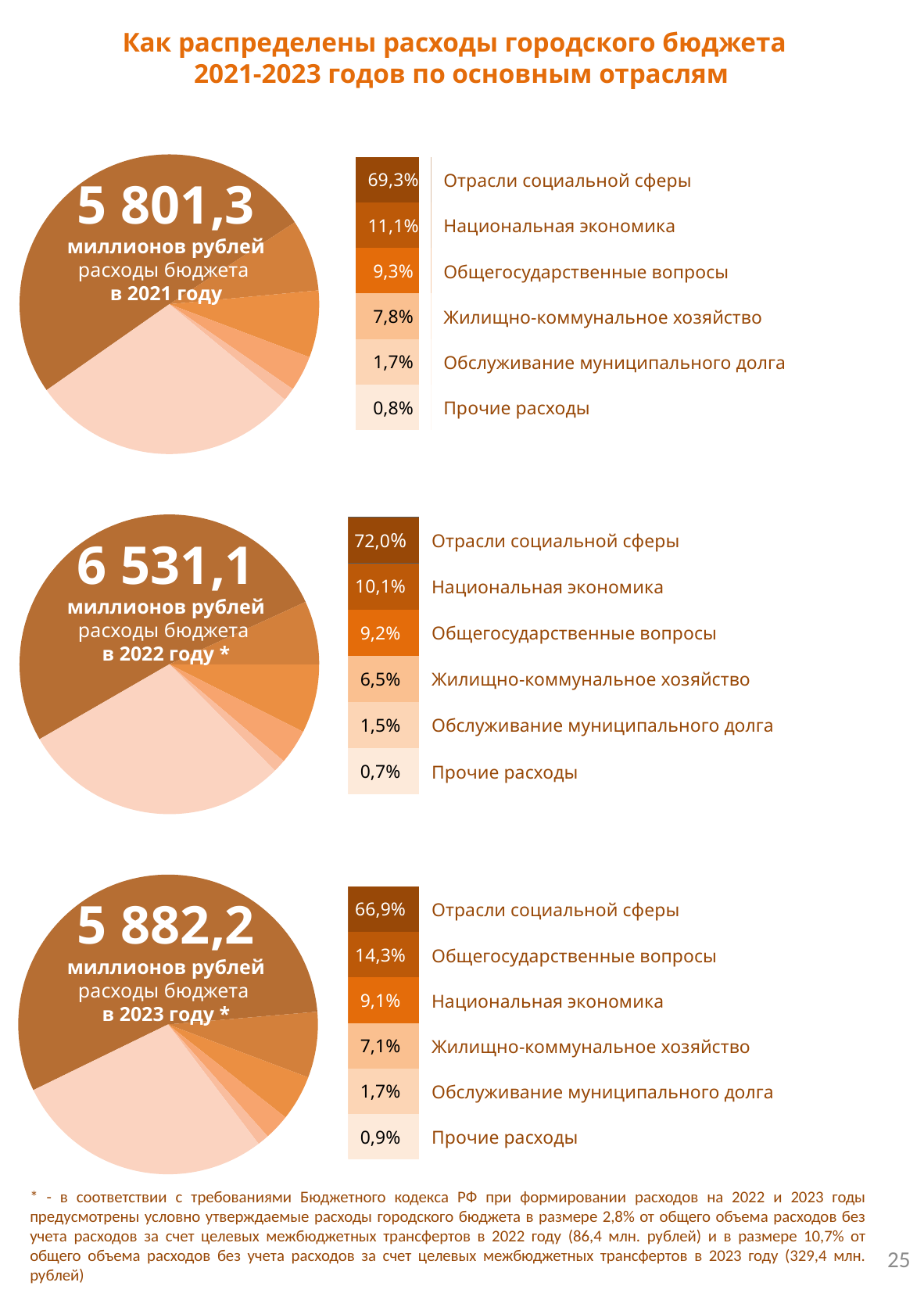
In the 2023 pie chart, which category has the smallest share? Прочие расходы In the 2022 pie chart, what share is shown for Жилищно-коммунальное хозяйство? 6,5% In the 2021 pie chart, what share of budget expenditures goes to Отрасли социальной сферы? 69,3% In the 2023 pie chart, what share is shown for Общегосударственные вопросы? 14,3% What total budget expenditure is shown in the centre of the 2022 pie chart? 6 531,1 миллионов рублей How many pie charts are shown on the slide? 3 In the 2023 pie chart, which is larger: the share of Общегосударственные вопросы or the share of Национальная экономика? Общегосударственные вопросы In the 2021 pie chart, which category has the largest share? Отрасли социальной сферы In the 2021 pie chart, what share is shown for Обслуживание муниципального долга? 1,7% How many categories does the legend of the 2021 pie chart list? 6 What type of chart is used to show the 2023 budget expenditure distribution? Pie chart In the 2022 pie chart, what is the difference between the shares of Национальная экономика and Общегосударственные вопросы? 0,9%